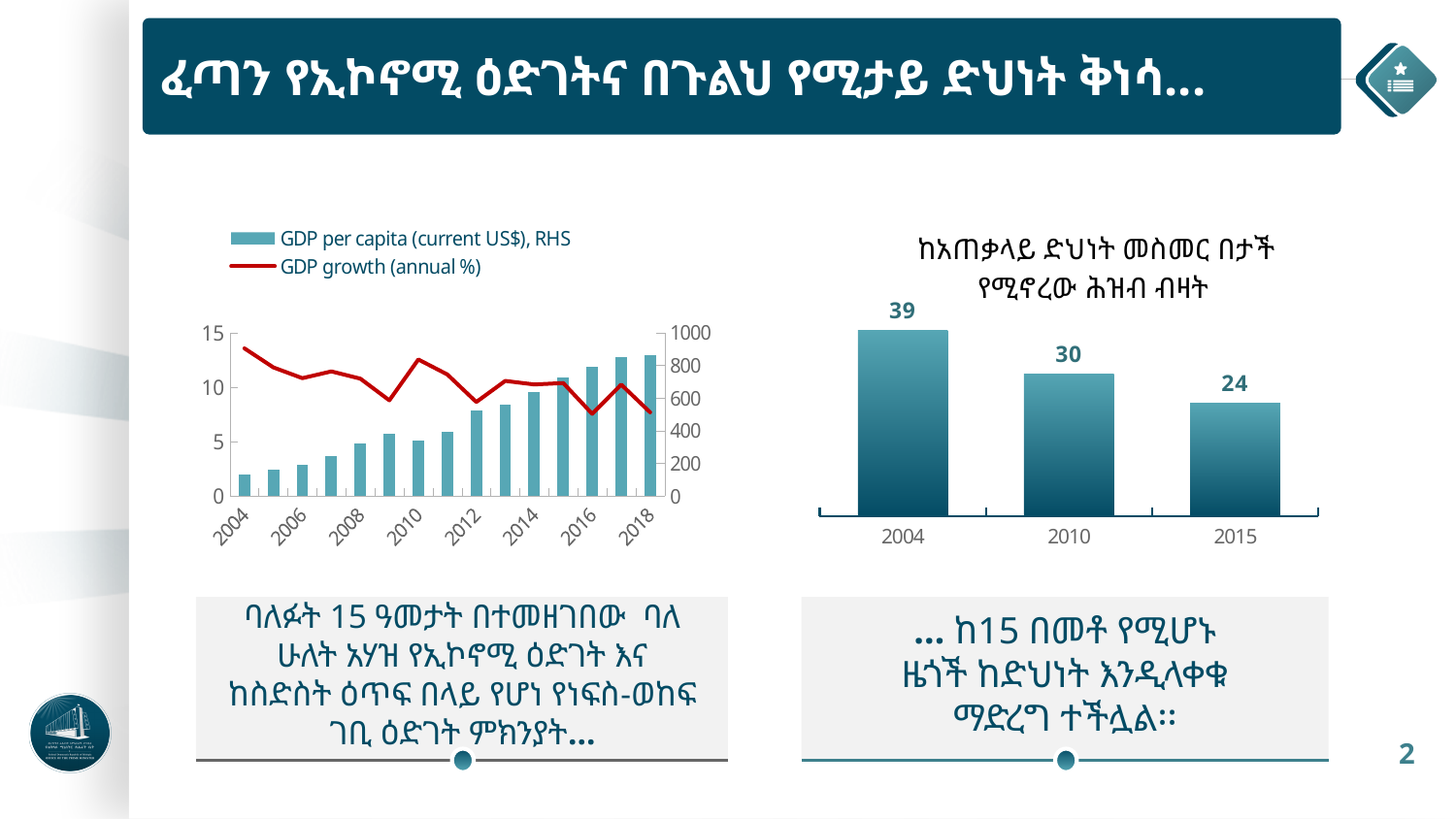
In the right chart, which year has the highest value? 2004 In the right chart, how many bars are plotted? 3 In the left chart, how many series does the legend list? 2 In the right chart, do the values rise or fall from 2004 to 2015? fall In the right chart, what is the difference between the values for 2004 and 2015? 15 In the left chart, is the GDP per capita value for 2004 greater or less than 200? less In the left chart, do the GDP per capita bars generally rise or fall from 2004 to 2018? rise In the right chart, what is the value for 2015? 24 In the left chart, is the GDP growth value for 2004 greater or less than 10? greater In the right chart, which year has the lowest value? 2015 In the right chart, what is the value for 2004? 39 In the right chart, which is larger, the value for 2010 or the value for 2015? 2010